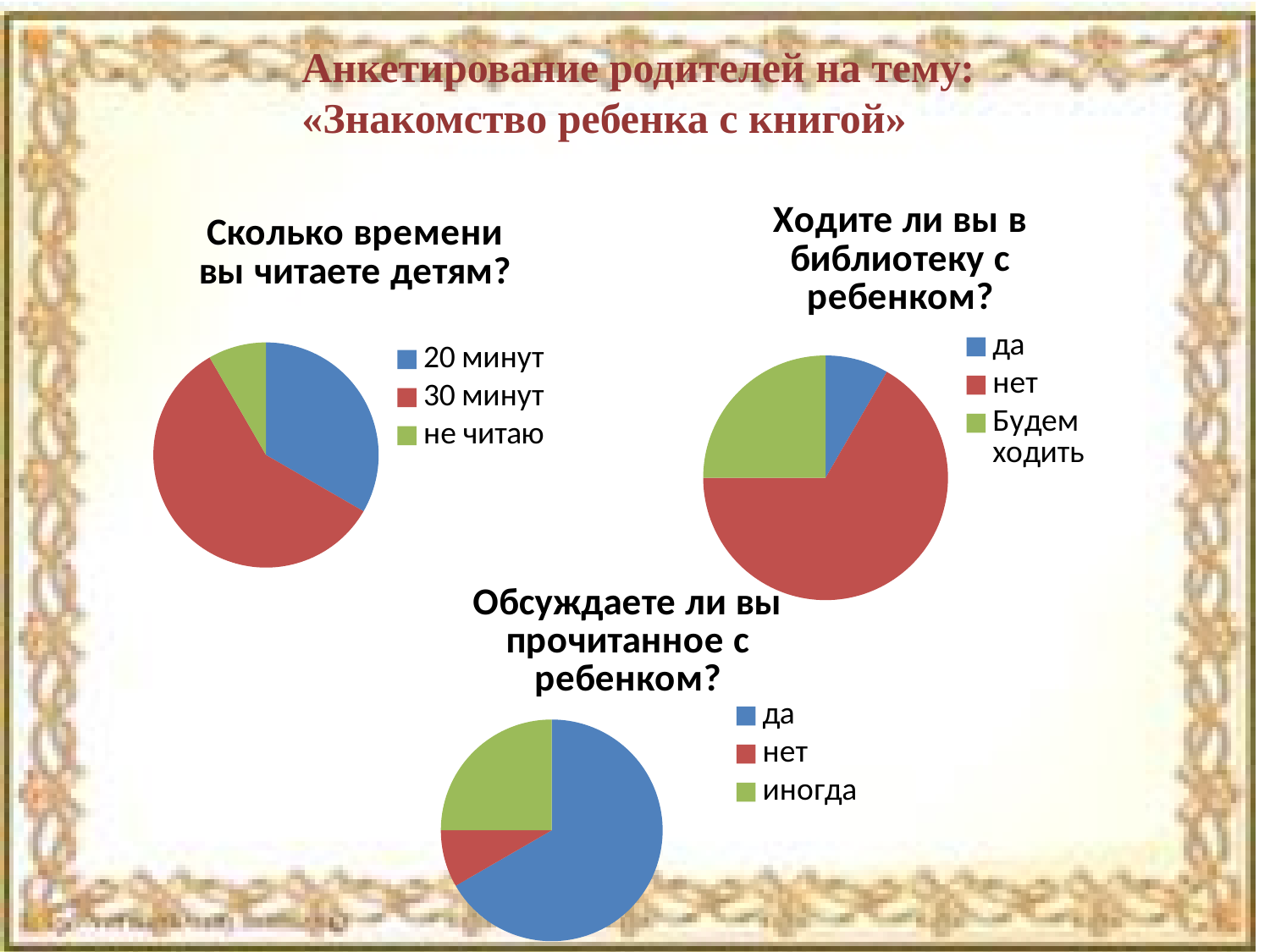
In the chart "Ходите ли вы в библиотеку с ребенком?", which slice is larger: "Будем ходить" or "да"? Будем ходить In the chart "Сколько времени вы читаете детям?", which slice is larger: "20 минут" or "не читаю"? 20 минут In the chart "Сколько времени вы читаете детям?", which category has the smallest slice? не читаю In the chart "Сколько времени вы читаете детям?", which category has the largest slice? 30 минут In the chart "Обсуждаете ли вы прочитанное с ребенком?", which category has the largest slice? да How many categories does the legend of the chart "Сколько времени вы читаете детям?" list? 3 What kind of chart is used for "Сколько времени вы читаете детям?"? pie chart In the chart "Обсуждаете ли вы прочитанное с ребенком?", what colour represents "иногда"? green How many pie charts are shown on the slide? 3 In the chart "Ходите ли вы в библиотеку с ребенком?", which category has the smallest slice? да In the chart "Обсуждаете ли вы прочитанное с ребенком?", which category has the smallest slice? нет In the chart "Ходите ли вы в библиотеку с ребенком?", which category has the largest slice? нет